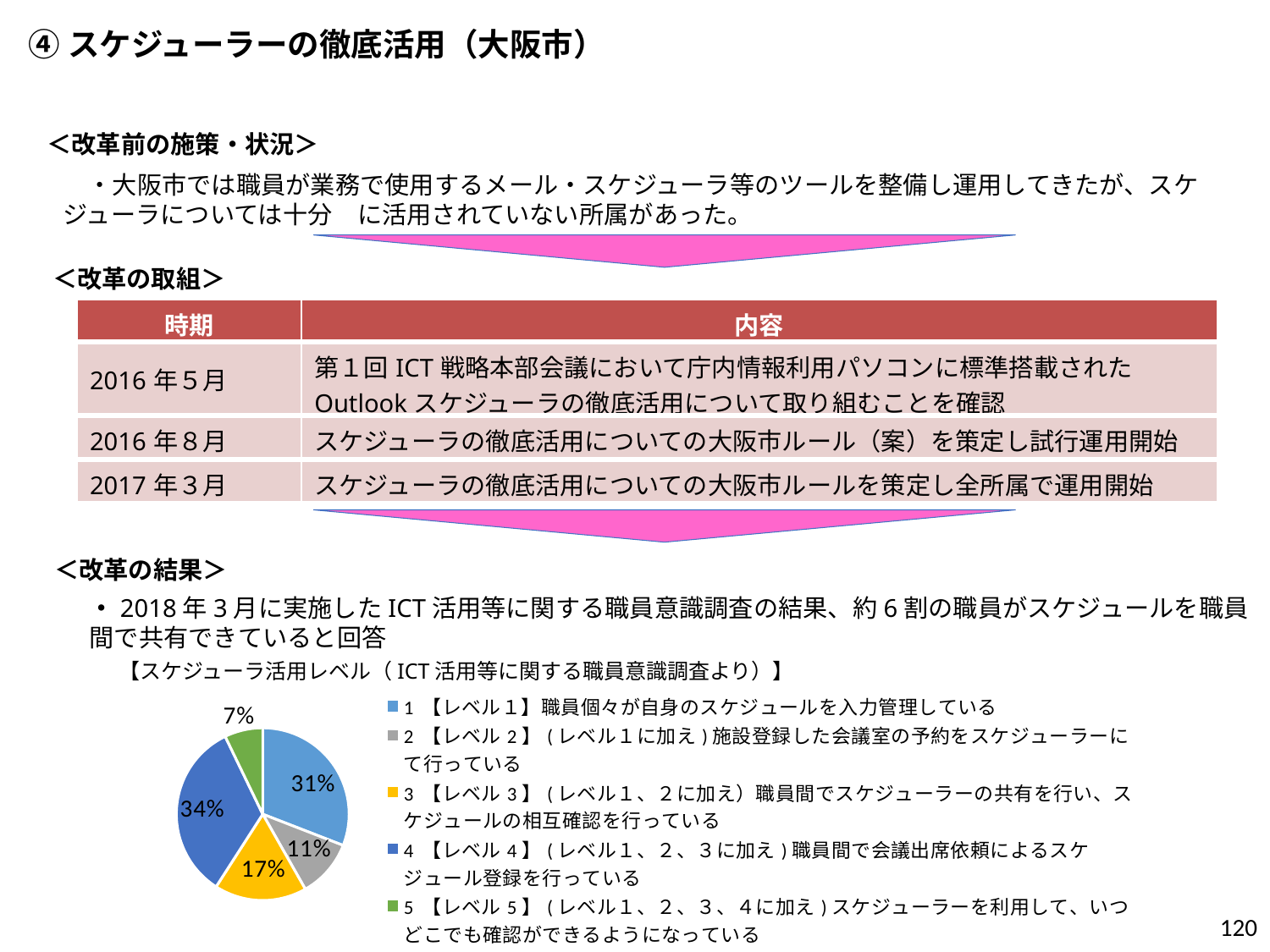
In the pie chart, what share is shown for レベル1 (職員個々が自身のスケジュールを入力管理している)? 31% In the pie chart, what share is shown for レベル5? 7% How many slices does the pie chart have? 5 Which slice is larger in the pie chart, レベル3 or レベル2? レベル3 In the pie chart, what share is shown for レベル4? 34% Which level has the largest slice in the pie chart? レベル4 Which level has the smallest slice in the pie chart? レベル5 In the pie chart, what share is shown for レベル2? 11% What colour is the レベル3 slice in the pie chart? yellow What is the difference in percentage points between the レベル4 slice and the レベル1 slice? 3 What kind of chart is shown at the bottom of the slide? pie chart In the pie chart, what share is shown for レベル3? 17%